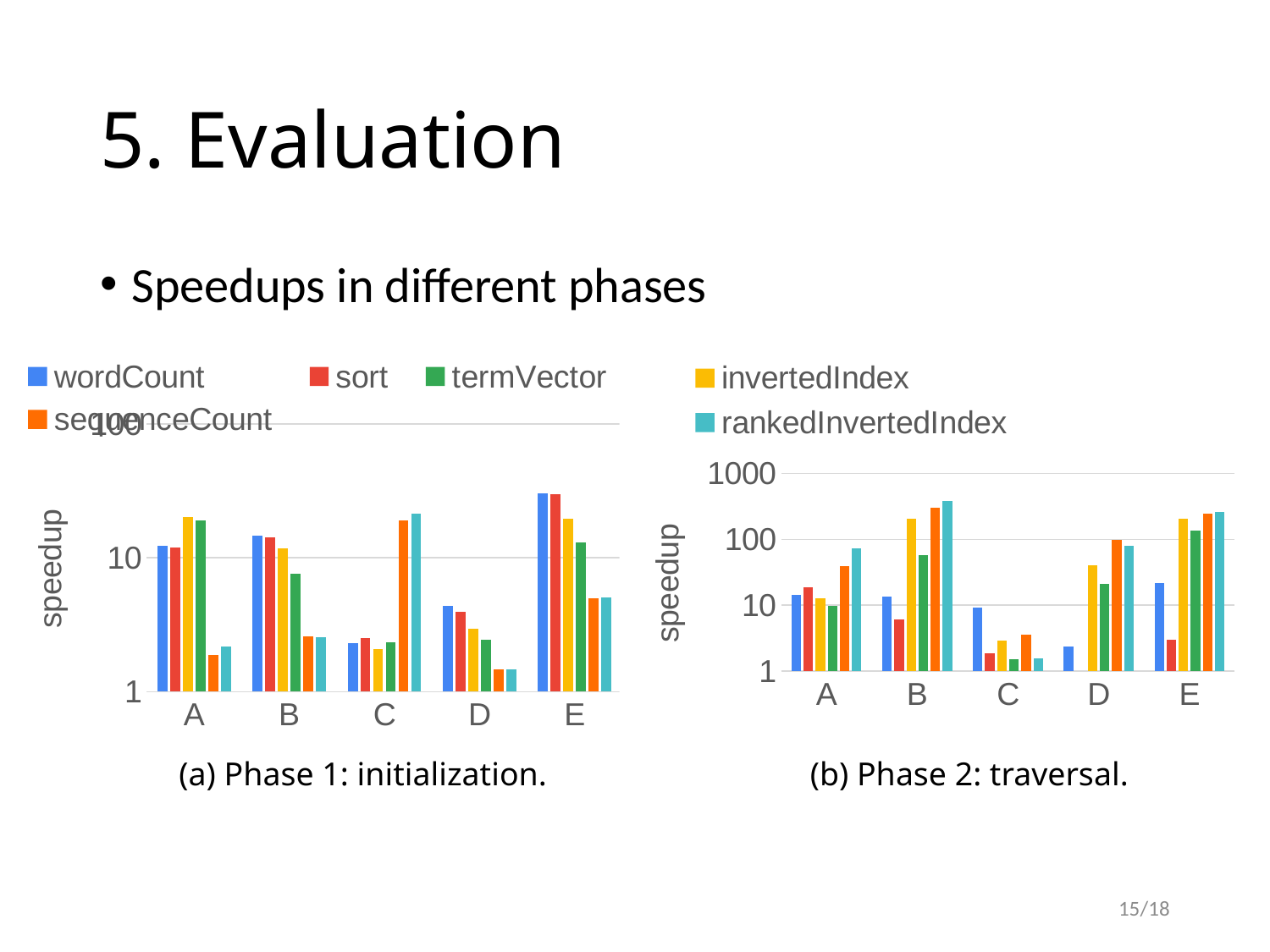
How many series does the legend list? 6 In (b) Phase 2: traversal, is the value for sort at C greater or less than 10? less In (b) Phase 2: traversal, which category has the highest rankedInvertedIndex value? B In (a) Phase 1: initialization, is the value for sequenceCount at D greater or less than 10? less How many categories are shown on the x axis of (b) Phase 2: traversal? 5 In (b) Phase 2: traversal, is the value for sequenceCount at D greater or less than 10? greater In (b) Phase 2: traversal, which category has the lowest wordCount value? D What kind of chart is used in (a) Phase 1: initialization? bar chart In (b) Phase 2: traversal, which is larger at B, wordCount or sort? wordCount What is the label on the y axis of both charts? speedup